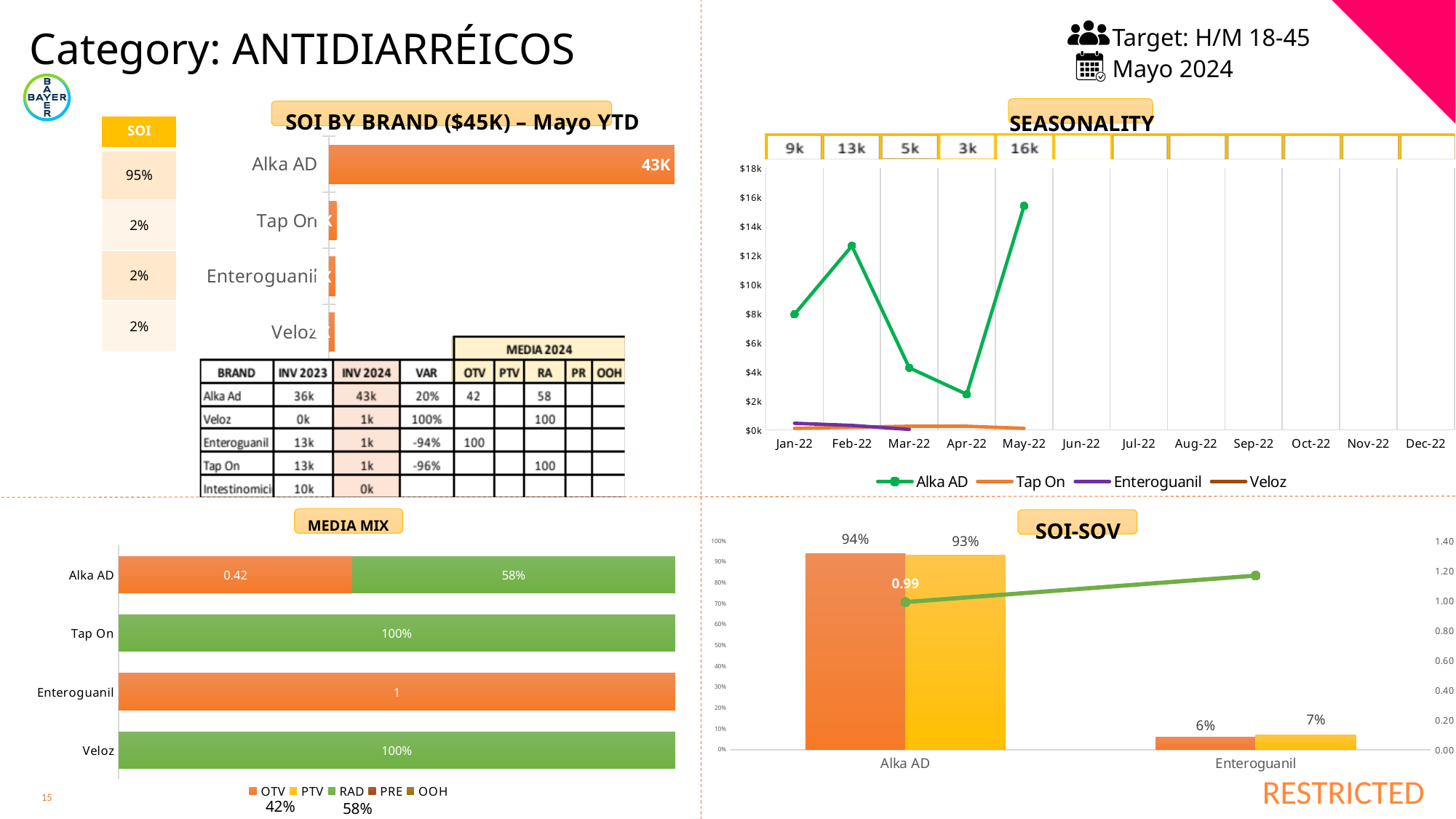
In the SEASONALITY chart, does the Alka AD line rise or fall from Feb-22 to Apr-22? fall How many series does the legend of the SEASONALITY chart list? 4 In the MEDIA MIX chart, what is the RAD value shown for Alka AD? 58% In the SEASONALITY chart, in which month does the Alka AD line reach its highest point? May-22 How many brands are plotted in the SOI BY BRAND chart? 4 In the SOI BY BRAND chart, which brand has the highest value? Alka AD How many series does the legend of the MEDIA MIX chart list? 5 In the SOI BY BRAND chart, what is the value shown for Alka AD? 43K What kind of chart is the SEASONALITY chart? line chart In the SEASONALITY chart, in which month is the Alka AD line at its lowest? Apr-22 In the SEASONALITY chart, is the Alka AD value for Apr-22 greater or less than $4k? less In the SOI-SOV chart, what is the difference between the first bar for Alka AD (94%) and the first bar for Enteroguanil (6%)? 88%